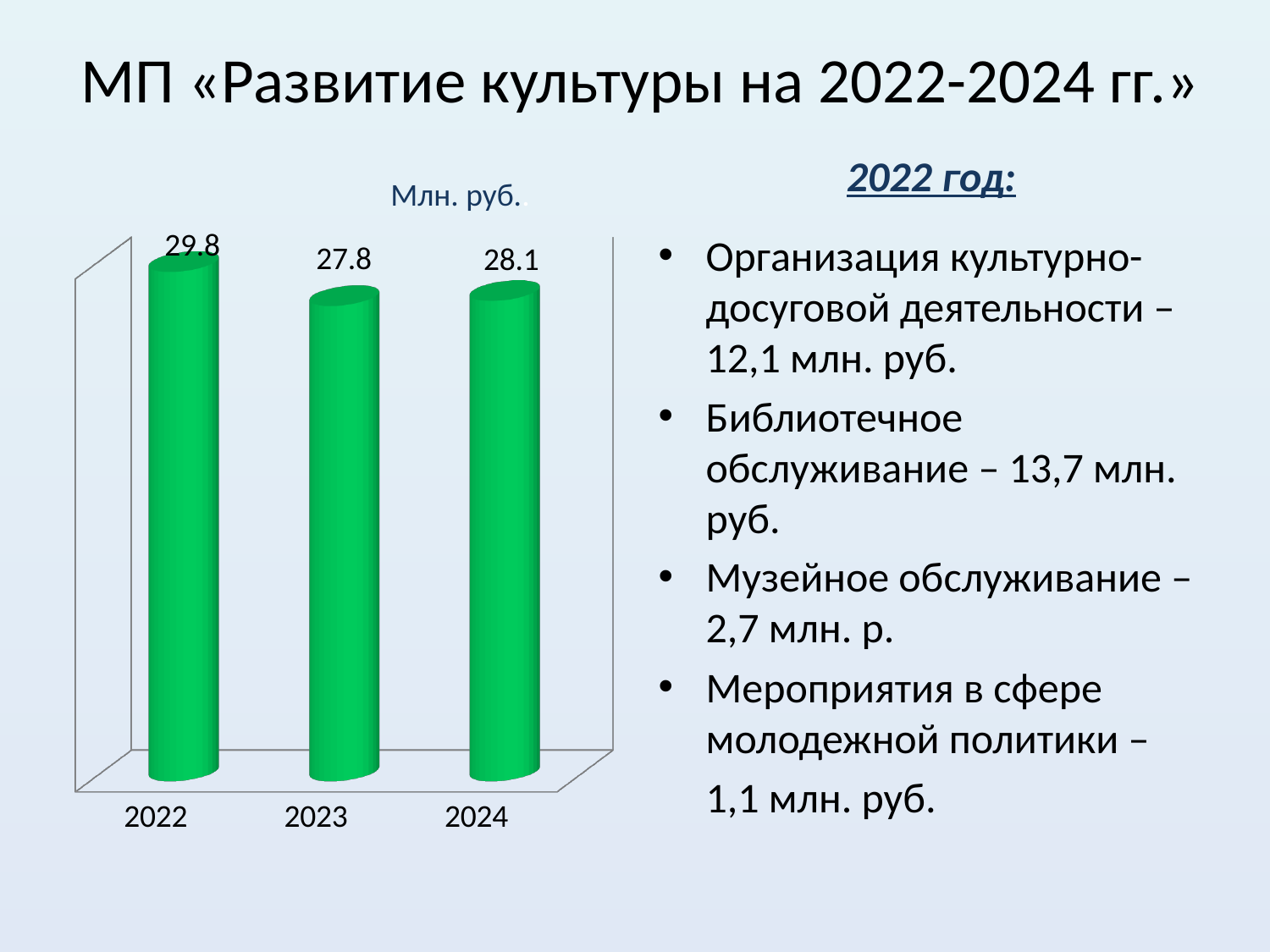
How many years are shown in the chart? 3 What is the value for 2022 in the chart? 29.8 What is the difference between the values for 2022 and 2023? 2.0 What unit is given in the chart title? Млн. руб. Does the value fall or rise from 2022 to 2023? fall Which year has the lowest value in the chart? 2023 Which is larger, the value for 2022 or the value for 2024? 2022 What is the value for 2024 in the chart? 28.1 Which year has the highest value in the chart? 2022 What is the difference between the values for 2024 and 2023? 0.3 What kind of chart is shown on the slide? bar chart What is the value for 2023 in the chart? 27.8